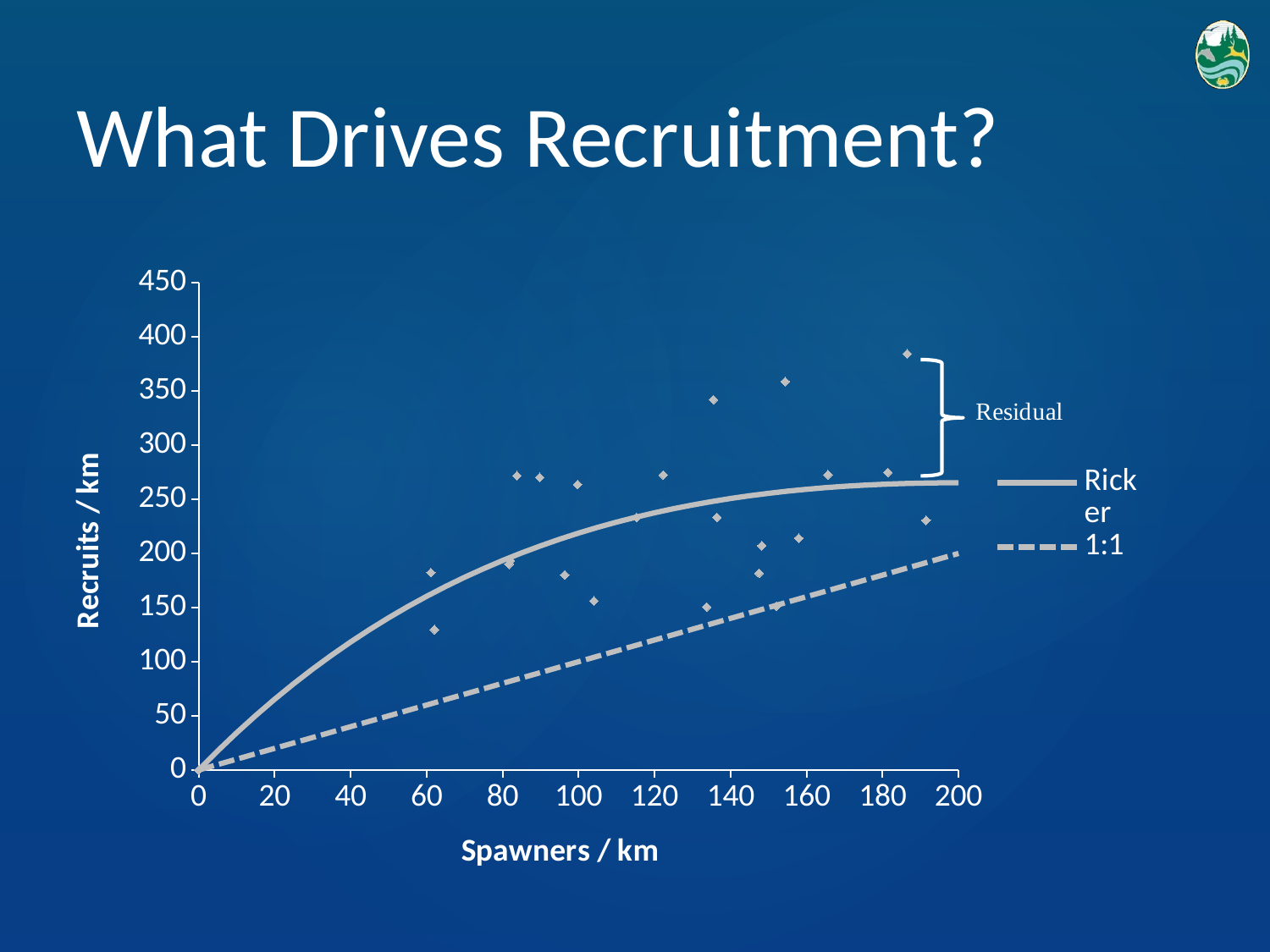
What is the label on the y axis of the chart? Recruits / km At 200 Spawners / km, which is higher: the Ricker curve or the 1:1 line? Ricker curve Is the value of the Ricker curve at 200 Spawners / km greater or less than 250? greater What is the maximum value shown on the y axis of the chart? 450 What are the two entries in the chart legend? Ricker and 1:1 What kind of chart is shown on the slide? scatter chart Is the lowest plotted data point greater or less than 150 Recruits / km? less Is the highest plotted data point greater or less than 350 Recruits / km? greater Does the Ricker curve rise or fall as Spawners / km increases? rise How many series does the chart legend list? 2